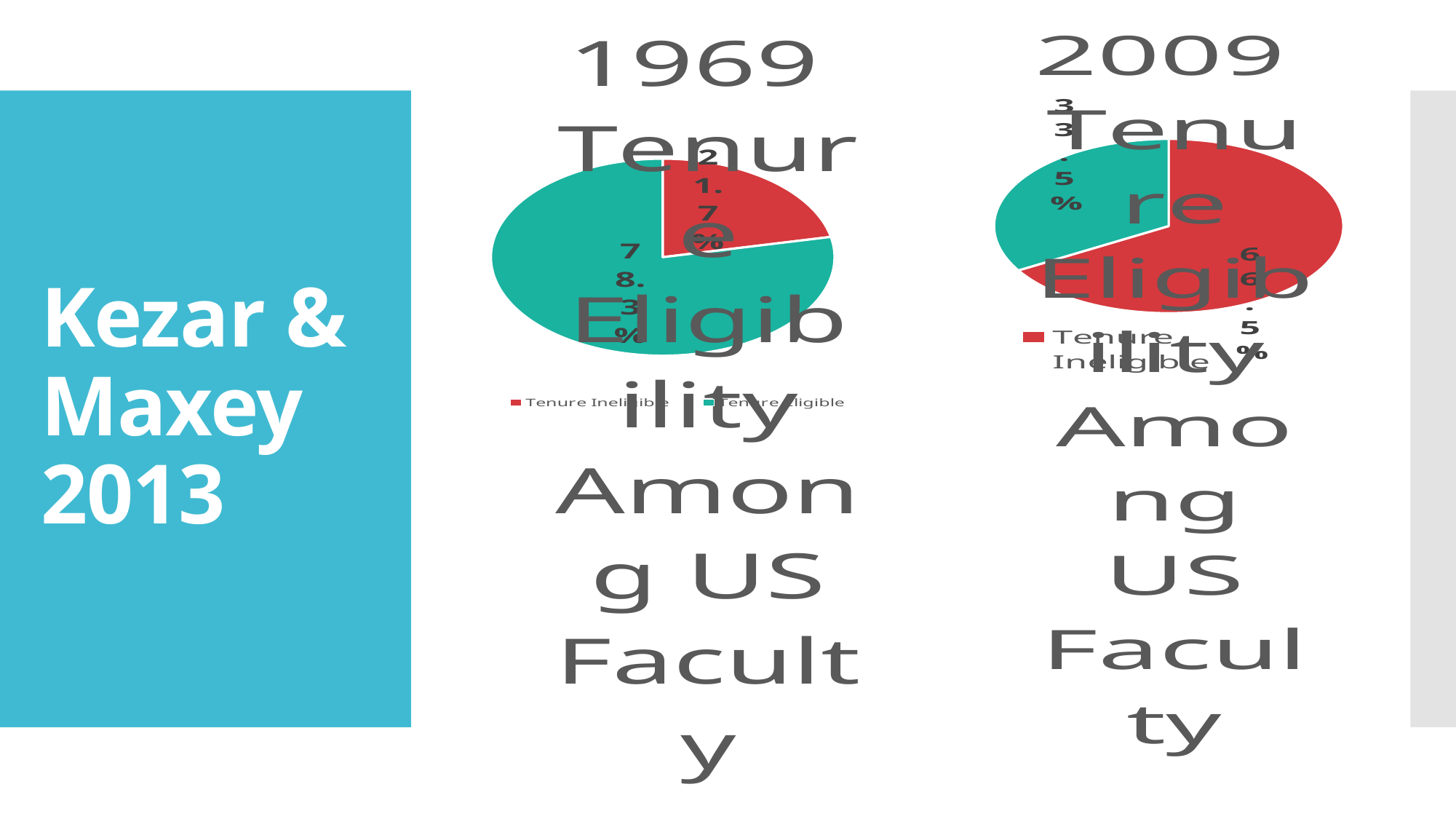
In the 2009 Tenure Eligibility Among US Faculty chart, what share is shown for the red Tenure Ineligible slice? 66.5% Which chart shows the larger Tenure Ineligible share, the 1969 chart or the 2009 chart? the 2009 chart In the 1969 Tenure Eligibility Among US Faculty chart, what is the difference between the Tenure Eligible and Tenure Ineligible shares? 56.6% In the 2009 Tenure Eligibility Among US Faculty chart, what share is shown for the teal slice? 33.5% In the 2009 Tenure Eligibility Among US Faculty chart, which slice is larger, the red one or the teal one? the red one In the 1969 Tenure Eligibility Among US Faculty chart, what share of faculty is Tenure Eligible? 78.3% In the 1969 Tenure Eligibility Among US Faculty chart, which category has the largest slice? Tenure Eligible In the 1969 Tenure Eligibility Among US Faculty chart, what share of faculty is Tenure Ineligible? 21.7% What kind of chart is the 1969 Tenure Eligibility Among US Faculty chart? pie chart In the 1969 Tenure Eligibility Among US Faculty chart, how many slices does the pie have? 2 In the 2009 Tenure Eligibility Among US Faculty chart, what is the difference between the two slices' shares? 33.0% In the 1969 Tenure Eligibility Among US Faculty chart, what colour is the Tenure Ineligible slice? red